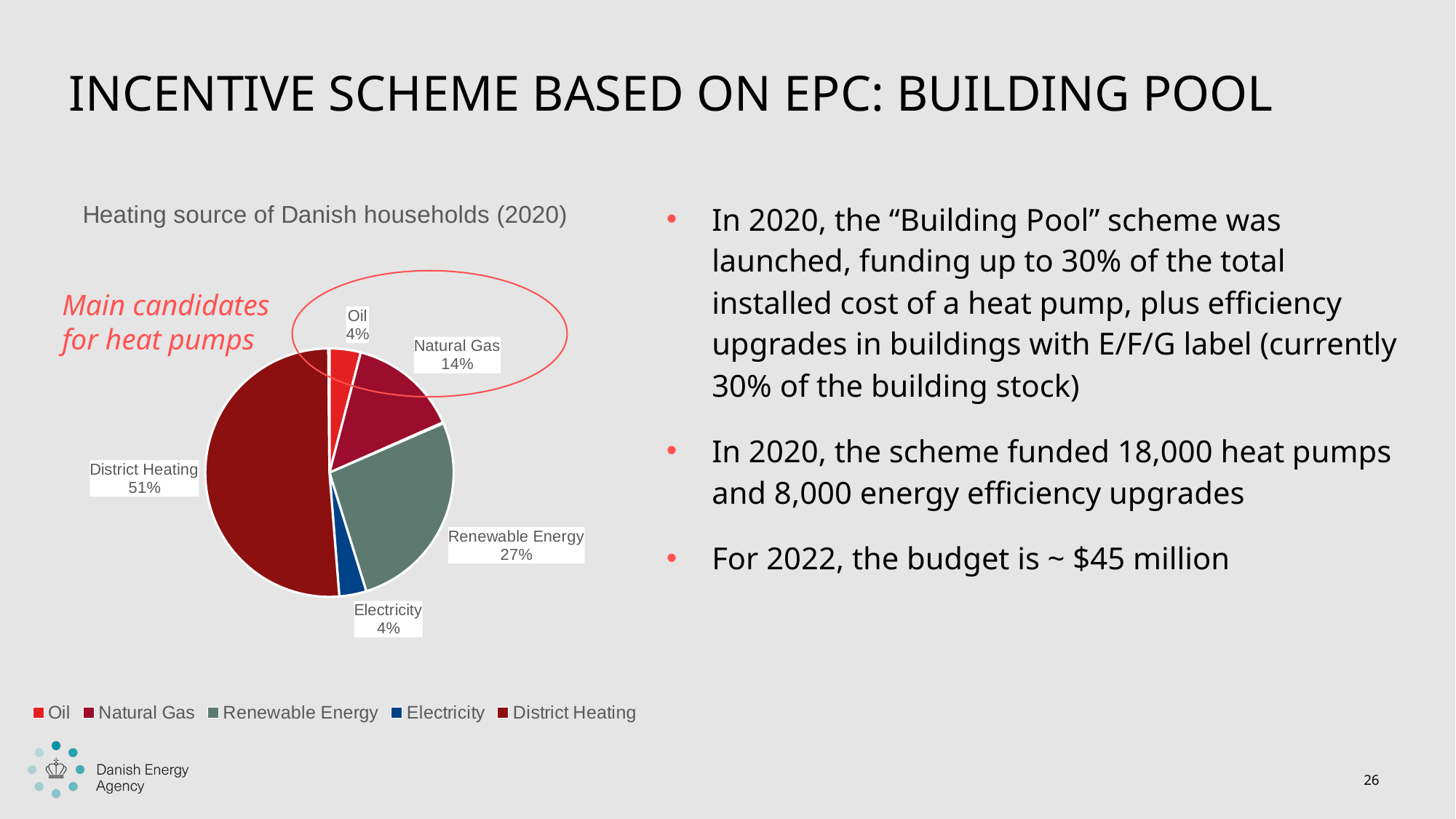
What share of Danish households used District Heating as their heating source in 2020? 51% What is the difference in percentage points between Natural Gas and Oil? 10 What share does Natural Gas have in the heating source pie chart? 14% What type of chart is used to show the heating source of Danish households? Pie chart Which two heating sources are circled as the main candidates for heat pumps? Oil and Natural Gas Which heating source has the largest share in the pie chart? District Heating What is the title of the chart on the slide? Heating source of Danish households (2020) What percentage of the pie chart is Renewable Energy? 27% How many heating source categories are shown in the pie chart? 5 Which has a larger share, Renewable Energy or Natural Gas? Renewable Energy What is the difference in percentage points between District Heating and Renewable Energy? 24 What percentage of Danish households used Oil for heating in 2020? 4%